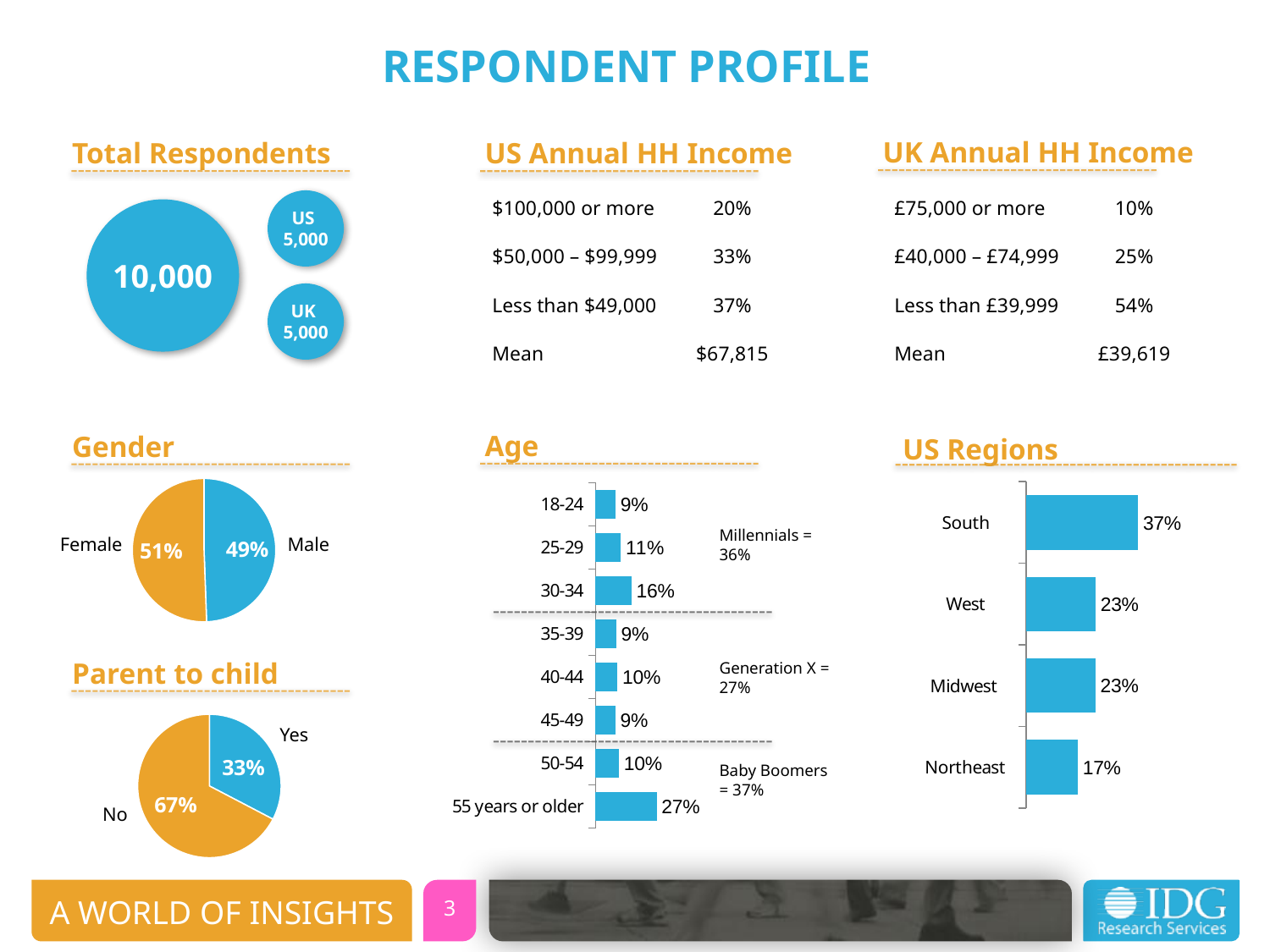
In the Age chart, what is the difference between the 55 years or older group and the 25-29 group? 16% In the Age chart, what is the value for the 30-34 age group? 16% What kind of chart is the US Regions chart? Bar chart In the US Regions chart, what is the value for the South? 37% In the Parent to child pie chart, what share of respondents answered Yes? 33% In the Parent to child pie chart, what is the difference between the No and Yes slices? 34% In the Gender pie chart, which slice is larger, Male or Female? Female In the Gender pie chart, what percentage of respondents are Female? 51% In the Age chart, which age group has the highest value? 55 years or older In the US Regions chart, what is the difference between the South and the Northeast? 20% In the Age chart, how many age groups are shown? 8 In the US Regions chart, which region has the lowest value? Northeast